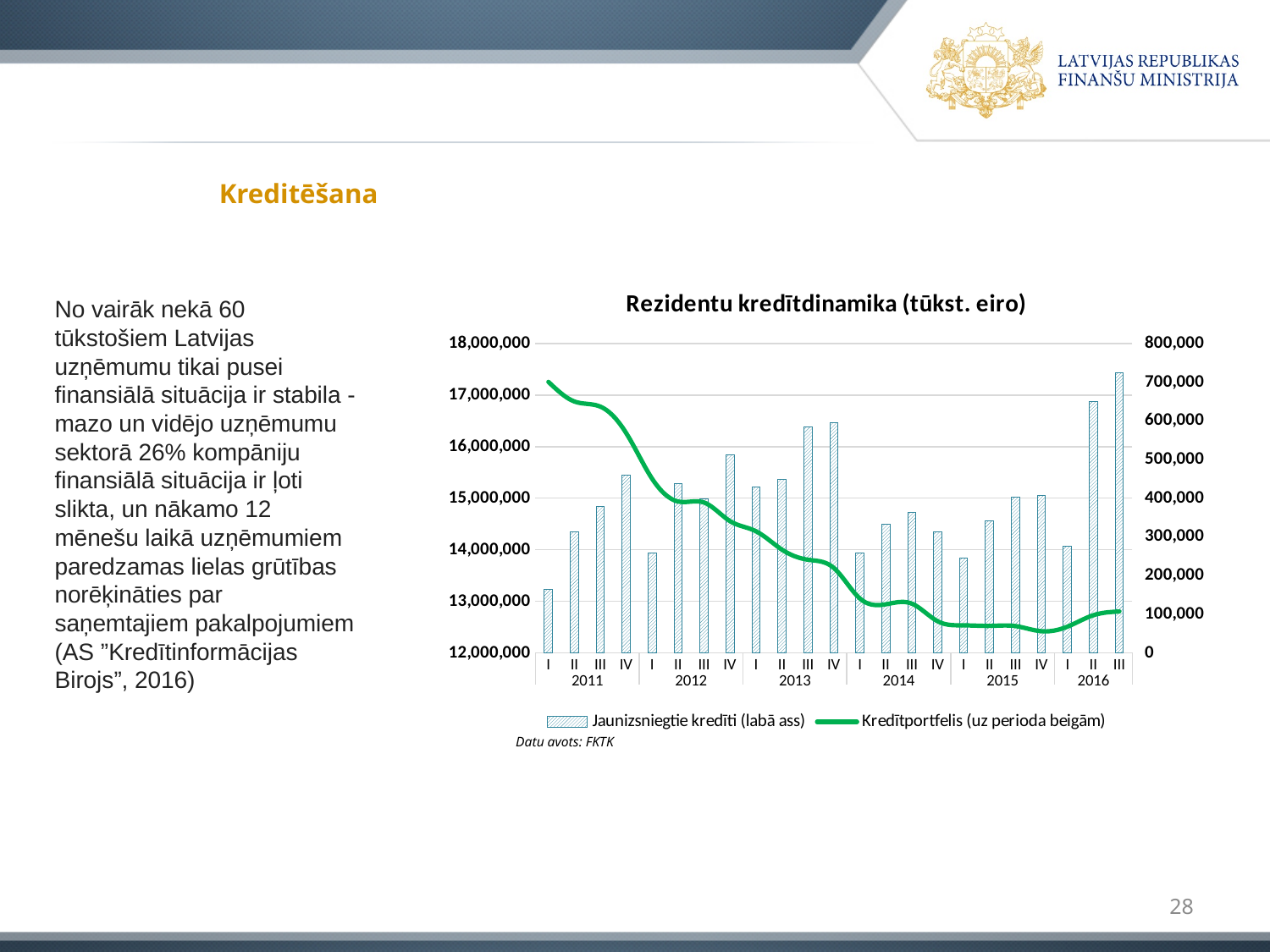
Is the Jaunizsniegtie kredīti value for 2016 III greater or less than 700,000? greater In which quarter is the Jaunizsniegtie kredīti bar the lowest? 2011 I What kind of chart is shown on the slide? A combination bar and line chart Is the Kredītportfelis value for 2016 III greater or less than 13,000,000? less What is the title of the chart? Rezidentu kredītdinamika (tūkst. eiro) According to the note below the chart, what is the data source? FKTK In which quarter is the Jaunizsniegtie kredīti bar the highest? 2016 III How many quarterly data points are plotted along the x axis of the chart? 23 Which has the larger Jaunizsniegtie kredīti bar, 2013 IV or 2014 I? 2013 IV How many series does the legend of the chart list? 2 Does the Kredītportfelis line rise or fall overall from 2011 I to 2016 III? Falls Is the Kredītportfelis value for 2011 I greater or less than 17,000,000? greater